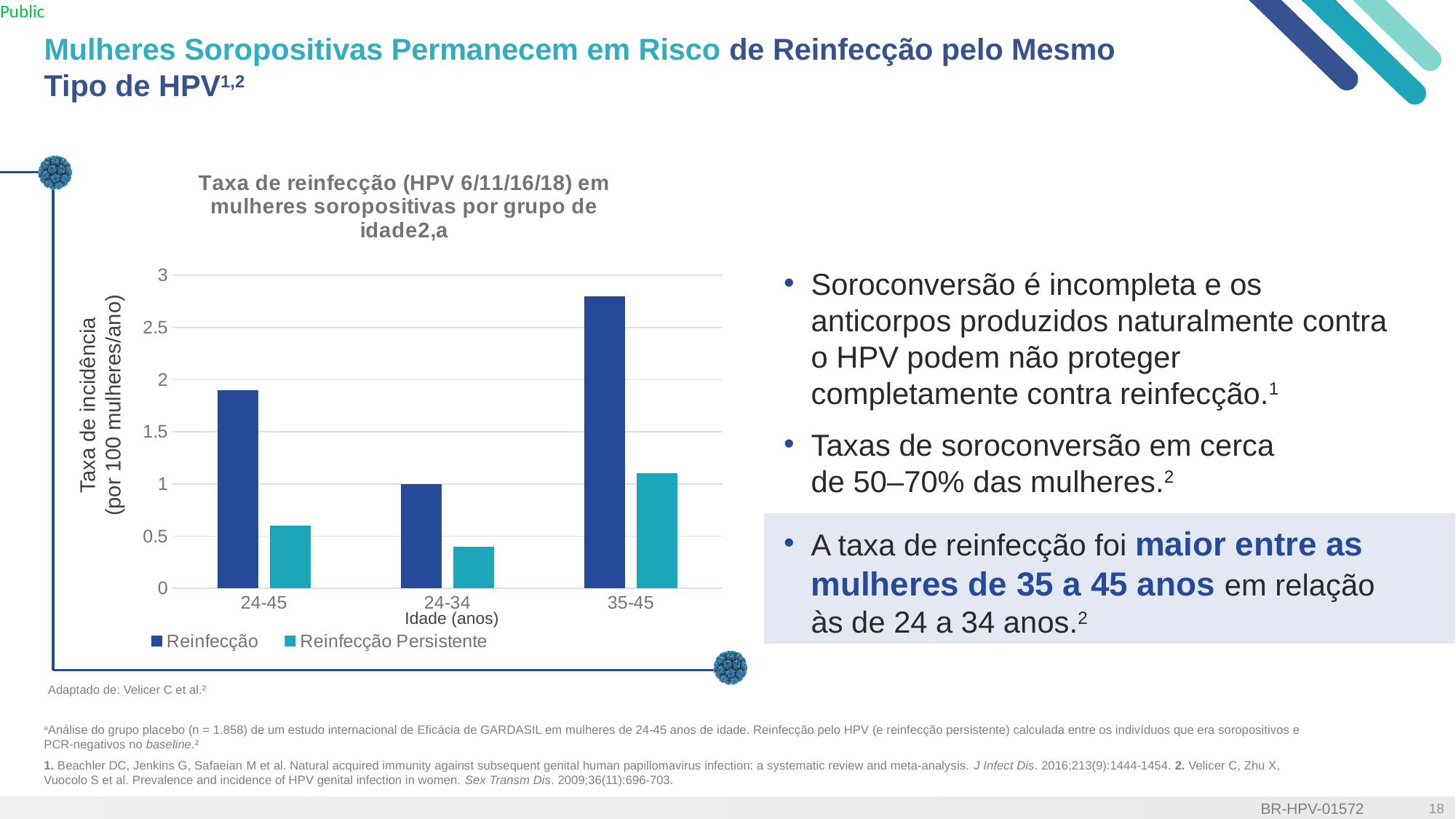
Which series is shown in dark blue in the chart? Reinfecção Which age group has the highest Reinfecção value? 35-45 What kind of chart is shown on the slide? bar chart Is the Reinfecção value for the 35-45 age group greater or less than 2.5? greater What is the label of the x axis of the chart? Idade (anos) Is the Reinfecção Persistente value for the 24-45 age group greater or less than 1? less Which is larger: the Reinfecção Persistente value for 35-45 or for 24-34? 35-45 Is the Reinfecção value for the 24-45 age group greater or less than 1.5? greater What is the Reinfecção value for the 24-34 age group? 1 Which age group has the lowest Reinfecção Persistente value? 24-34 How many age groups are shown on the x axis of the chart? 3 How many series does the chart legend list? 2